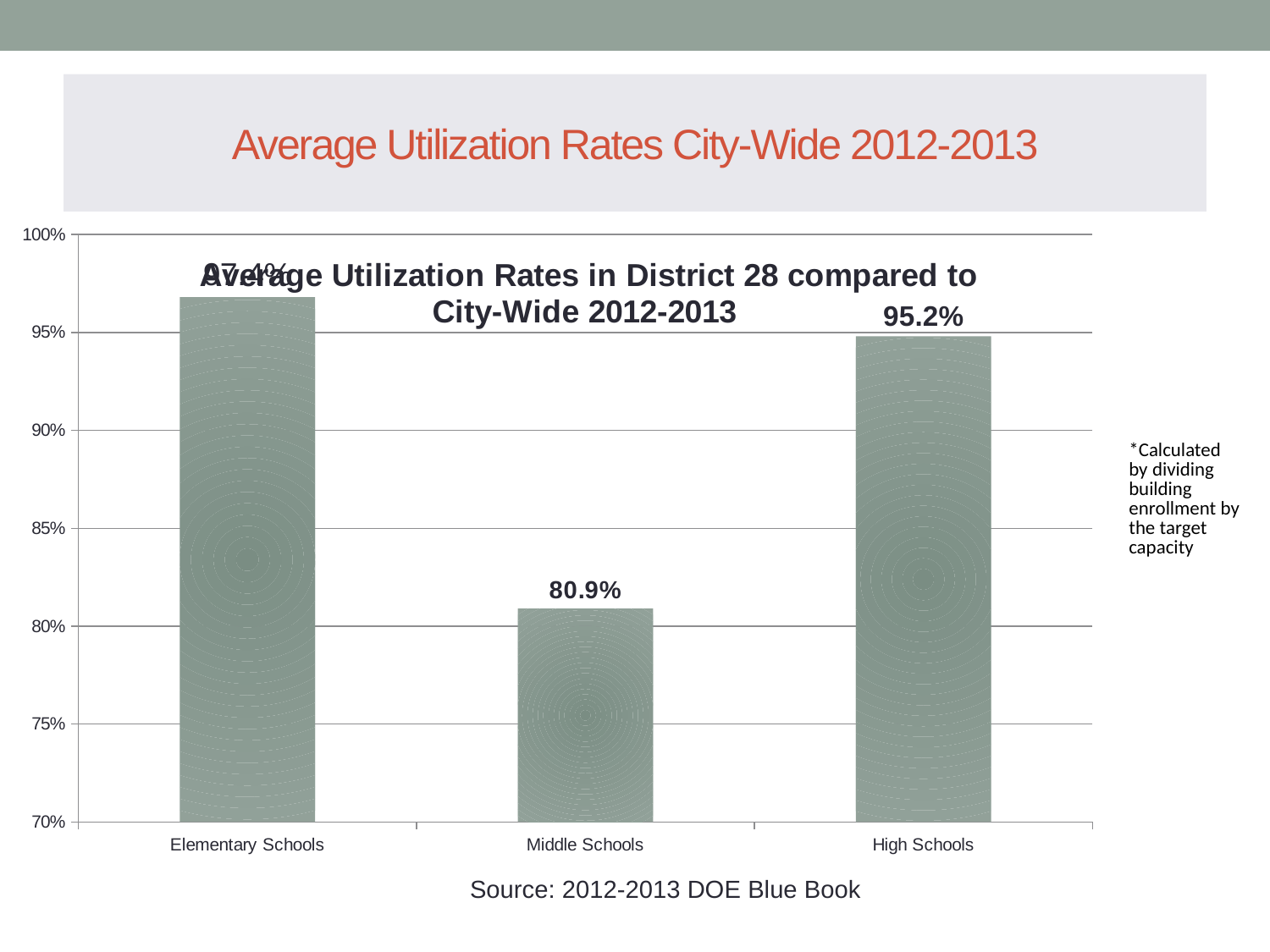
How many percentage points higher is the High Schools rate than the Middle Schools rate? 14.3 percentage points What is the highest value shown on the vertical axis? 100% How many school types are shown on the chart? 3 What is the average utilization rate for High Schools? 95.2% What source is cited below the chart? 2012-2013 DOE Blue Book Which school type has the highest average utilization rate? Elementary Schools Which school type has the lowest average utilization rate? Middle Schools What kind of chart is shown on the slide? Bar chart What is the average utilization rate for Middle Schools? 80.9% Is the value for Middle Schools greater or less than 85%? less Which has a higher utilization rate, Middle Schools or High Schools? High Schools Is the value for Elementary Schools greater or less than 95%? greater